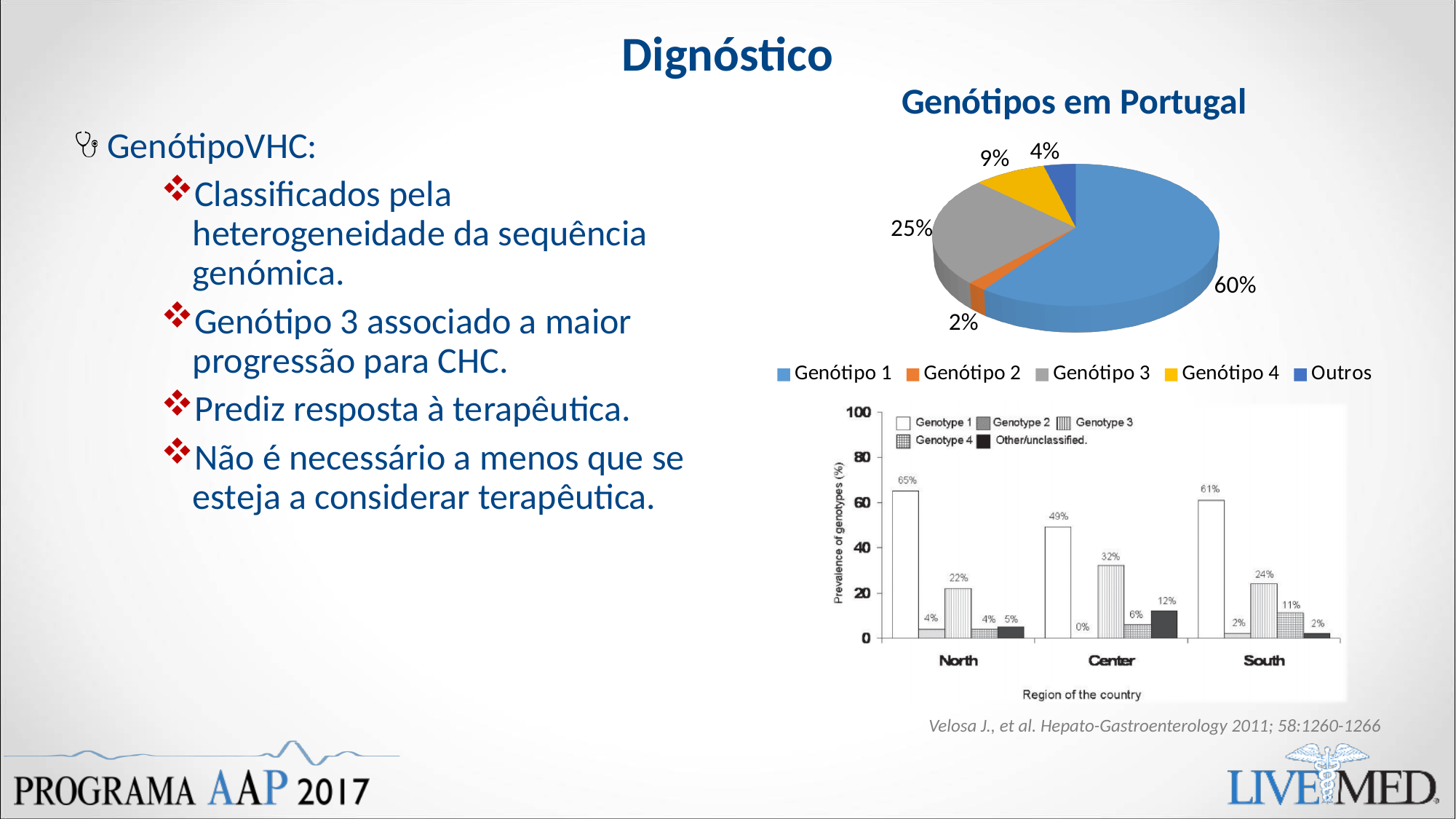
In the bar chart of prevalence by region, which region has the lowest value for Genotype 1? Center In the bar chart of prevalence by region, what is the value for Genotype 1 in the North? 65% In the bar chart of prevalence by region, what is the value for Genotype 3 in the Center? 32% In the bar chart of prevalence by region, is Genotype 4 larger in the South or in the North? South In the pie chart 'Genótipos em Portugal', what share does Genótipo 1 have? 60% In the pie chart 'Genótipos em Portugal', which genotype has the smallest slice? Genótipo 2 In the bar chart of prevalence by region, how many regions are shown on the x axis? 3 In the pie chart 'Genótipos em Portugal', what is the difference between the shares of Genótipo 4 and Outros? 5% In the bar chart of prevalence by region, what is the value for Other/unclassified in the Center? 12% In the pie chart 'Genótipos em Portugal', what share does Genótipo 3 have? 25% In the pie chart 'Genótipos em Portugal', how many entries does the legend list? 5 What kind of chart is the lower chart showing prevalence of genotypes by region? Bar chart